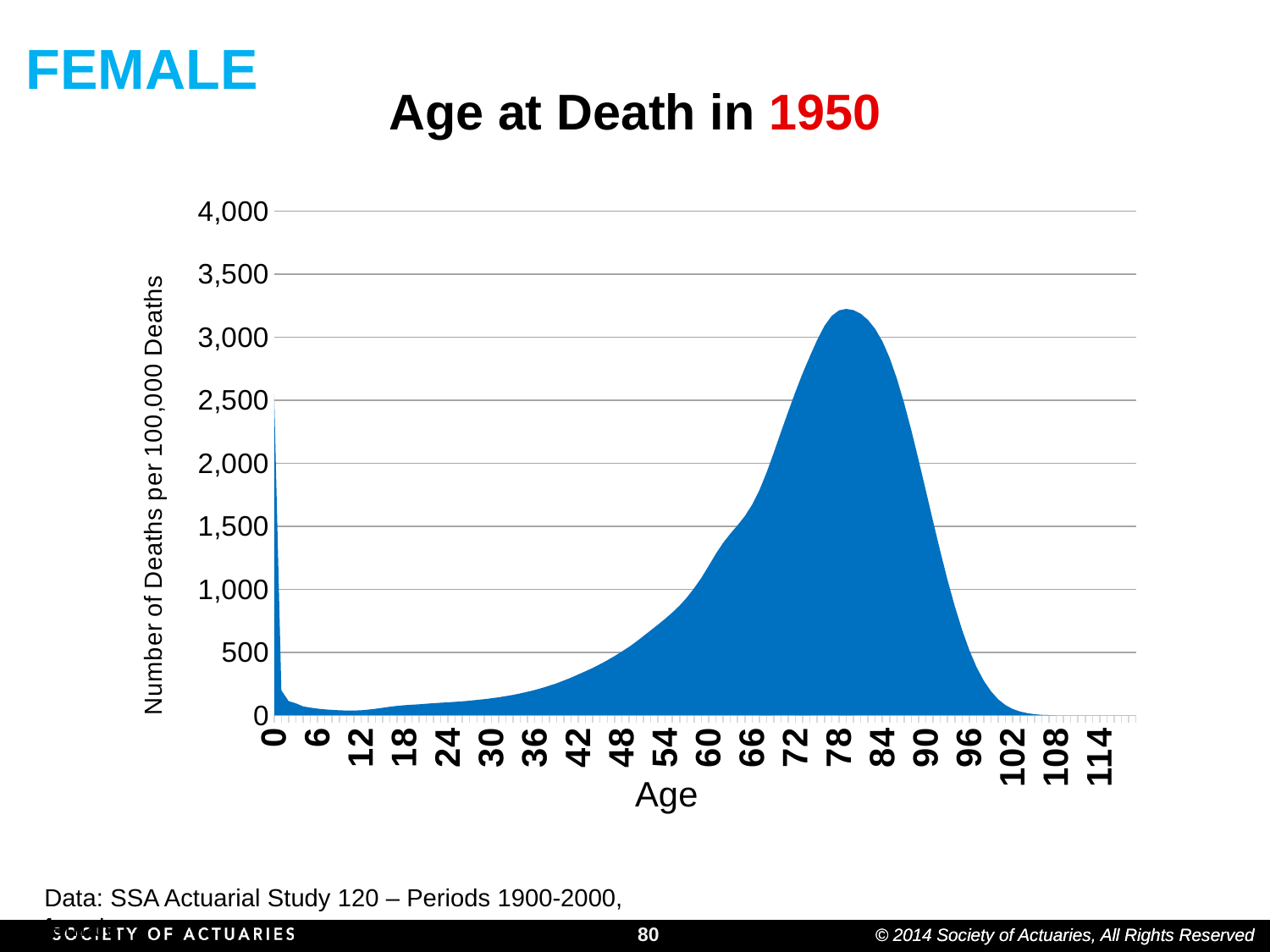
Which has the higher number of deaths, age 0 or age 30? age 0 Do the values rise or fall as age increases from 36 to 78? rise Is the value at age 0 greater or less than 2,000? greater Which has the higher number of deaths, age 0 or age 78? age 78 Is the value at age 30 greater or less than 500? less Is the value at age 102 greater or less than 500? less What is the label of the vertical axis? Number of Deaths per 100,000 Deaths What is the title of the chart? Age at Death in 1950 What kind of chart is shown on the slide? area chart Do the values rise or fall as age increases from 84 to 102? fall